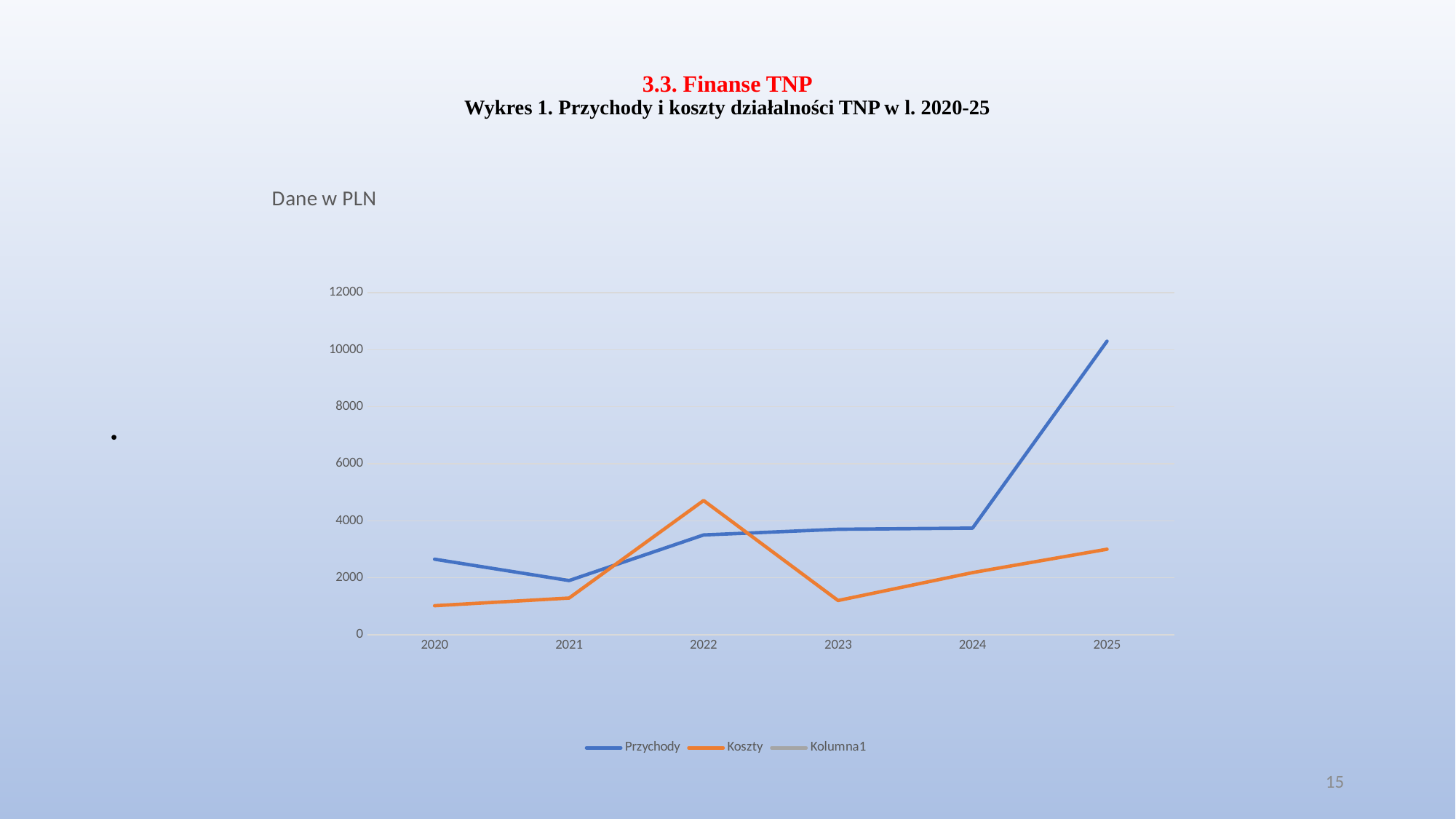
In which year is Przychody lowest? 2021 How many series does the legend list? 3 Is the value for Przychody in 2025 greater or less than 8000? greater What kind of chart is shown on the slide? line chart In which year is Koszty lowest? 2020 In which year is Przychody highest? 2025 What is the title shown above the chart area? Dane w PLN In which year is Koszty highest? 2022 Does Koszty rise or fall from 2023 to 2025? rise Is the value for Koszty in 2023 greater or less than 2000? less In 2022, which is larger, Przychody or Koszty? Koszty How many years are plotted along the x axis? 6